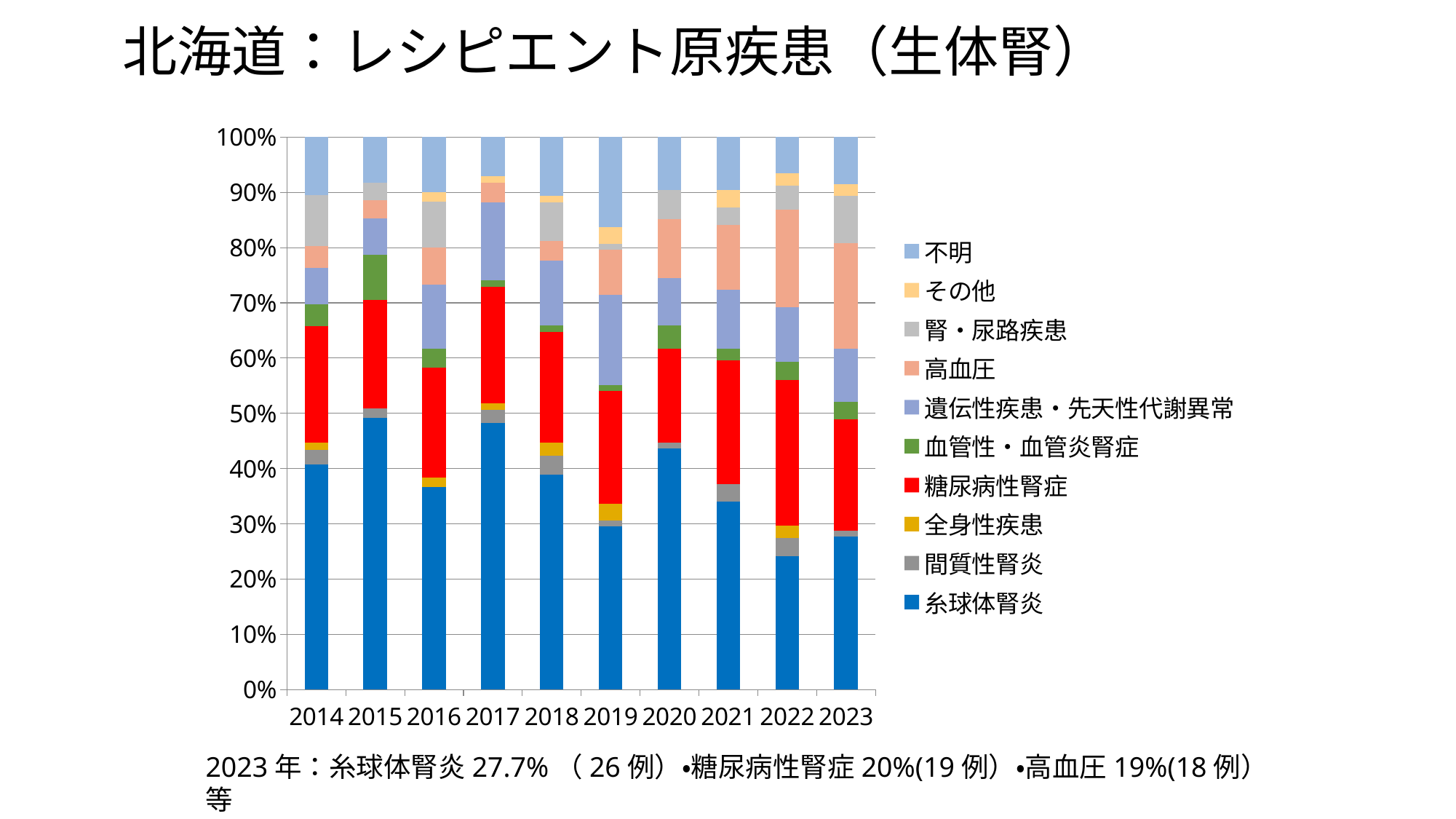
According to the slide, what share did 糸球体腎炎 have in 2023? 27.7% What type of chart is shown on the slide? Stacked bar chart In 2023, what is the difference in percentage points between 糸球体腎炎 (27.7%) and 糖尿病性腎症 (20%)? 7.7 Does the share of 高血圧 rise or fall from 2014 to 2023? rise According to the slide, what share did 糖尿病性腎症 have in 2023? 20% How many years are shown on the x axis of the chart? 10 According to the slide, how many cases (例) of 高血圧 were there in 2023? 18 例 Is the share of 糸球体腎炎 in 2020 greater or less than 40%? greater What is the title of the chart slide? 北海道：レシピエント原疾患（生体腎） In 2023, which is larger: the share of 糖尿病性腎症 or the share of 高血圧? 糖尿病性腎症 How many series does the legend list? 10 Is the share of 糸球体腎炎 in 2016 greater or less than 40%? less